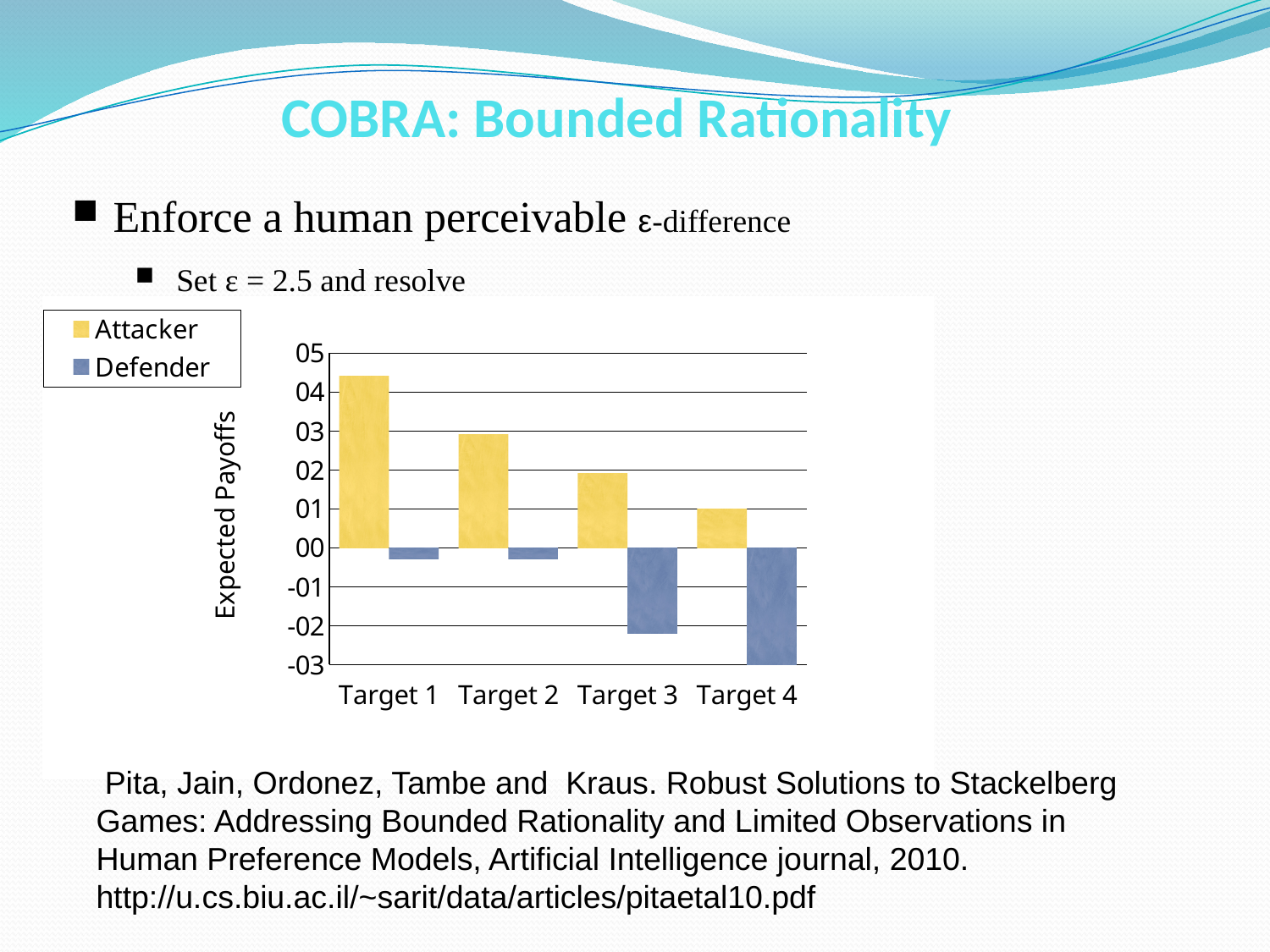
Which target has the highest Attacker expected payoff? Target 1 How many targets are shown on the x axis of the chart? 4 Which target has the lowest Attacker expected payoff? Target 4 Is the Attacker value for Target 2 greater or less than 02? greater Is the Defender value for Target 3 greater or less than -01? less How many series does the legend list? 2 What is the label on the y axis of the chart? Expected Payoffs Which is larger, the Attacker value for Target 2 or the Attacker value for Target 3? Target 2 Is the Attacker value for Target 1 greater or less than 04? greater What kind of chart is shown on the slide? bar chart Do the Attacker values rise or fall from Target 1 to Target 4? fall Which target has the lowest Defender expected payoff? Target 4